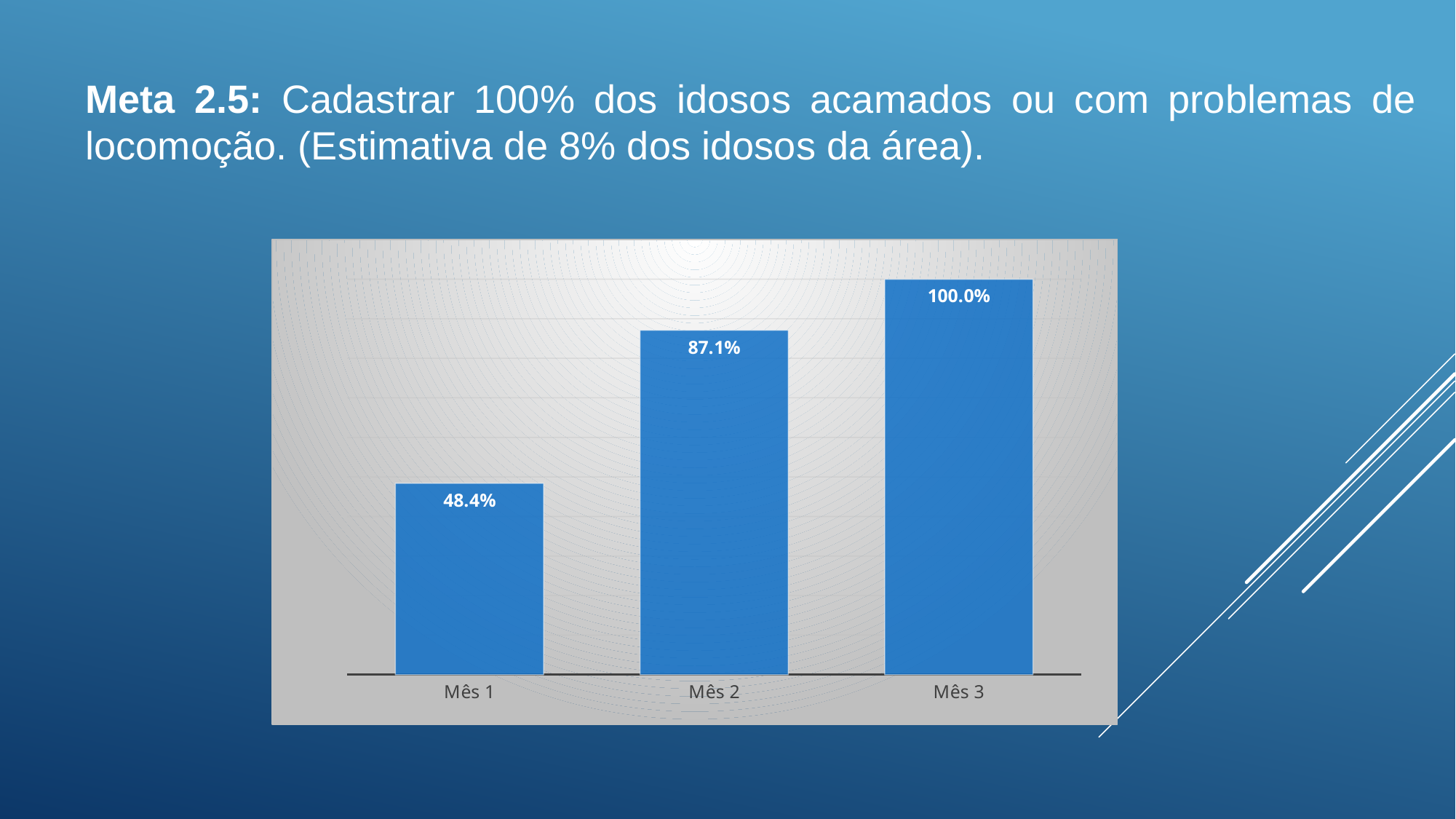
What is the value for Mês 3? 100.0% What kind of chart is shown on the slide? Bar chart What is the value for Mês 1? 48.4% Which is larger, the value for Mês 1 or the value for Mês 2? Mês 2 What is the difference between the values for Mês 3 and Mês 2? 12.9% What is the value for Mês 2? 87.1% Which month has the lowest value? Mês 1 Which month has the highest value? Mês 3 Do the values rise or fall from Mês 1 to Mês 3? Rise How many categories are shown on the x axis? 3 What is the difference between the values for Mês 2 and Mês 1? 38.7% What colour are the bars in the chart? Blue